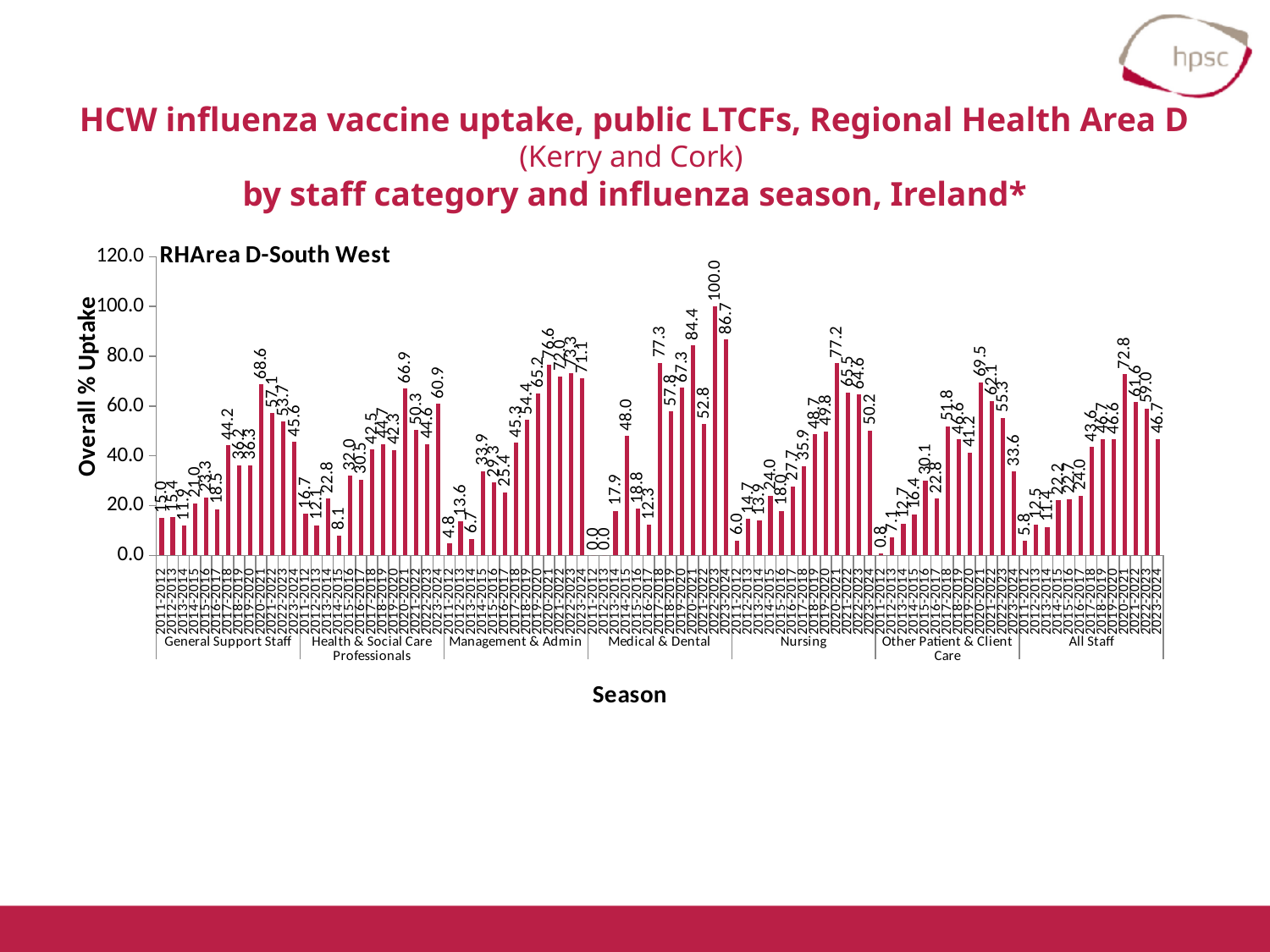
What is the difference between the All Staff uptake in 2020-2021 and in 2023-2024? 26.1 What kind of chart is shown on the slide? bar chart What is the uptake value for Other Patient & Client Care in the 2023-2024 season? 33.6 What is the uptake value for Medical & Dental in the 2022-2023 season? 100.0 In the 2020-2021 season, which is larger: the uptake for Nursing or for General Support Staff? Nursing What is the title printed inside the chart area? RHArea D-South West How many staff categories are shown along the x axis? 7 Is the uptake value for Medical & Dental in 2017-2018 greater or less than 60? greater What is the label on the vertical axis of the chart? Overall % Uptake Which staff category and season has the highest uptake value on the chart? Medical & Dental, 2022-2023 What is the uptake value for All Staff in the 2020-2021 season? 72.8 What is the uptake value for Medical & Dental in the 2023-2024 season? 86.7